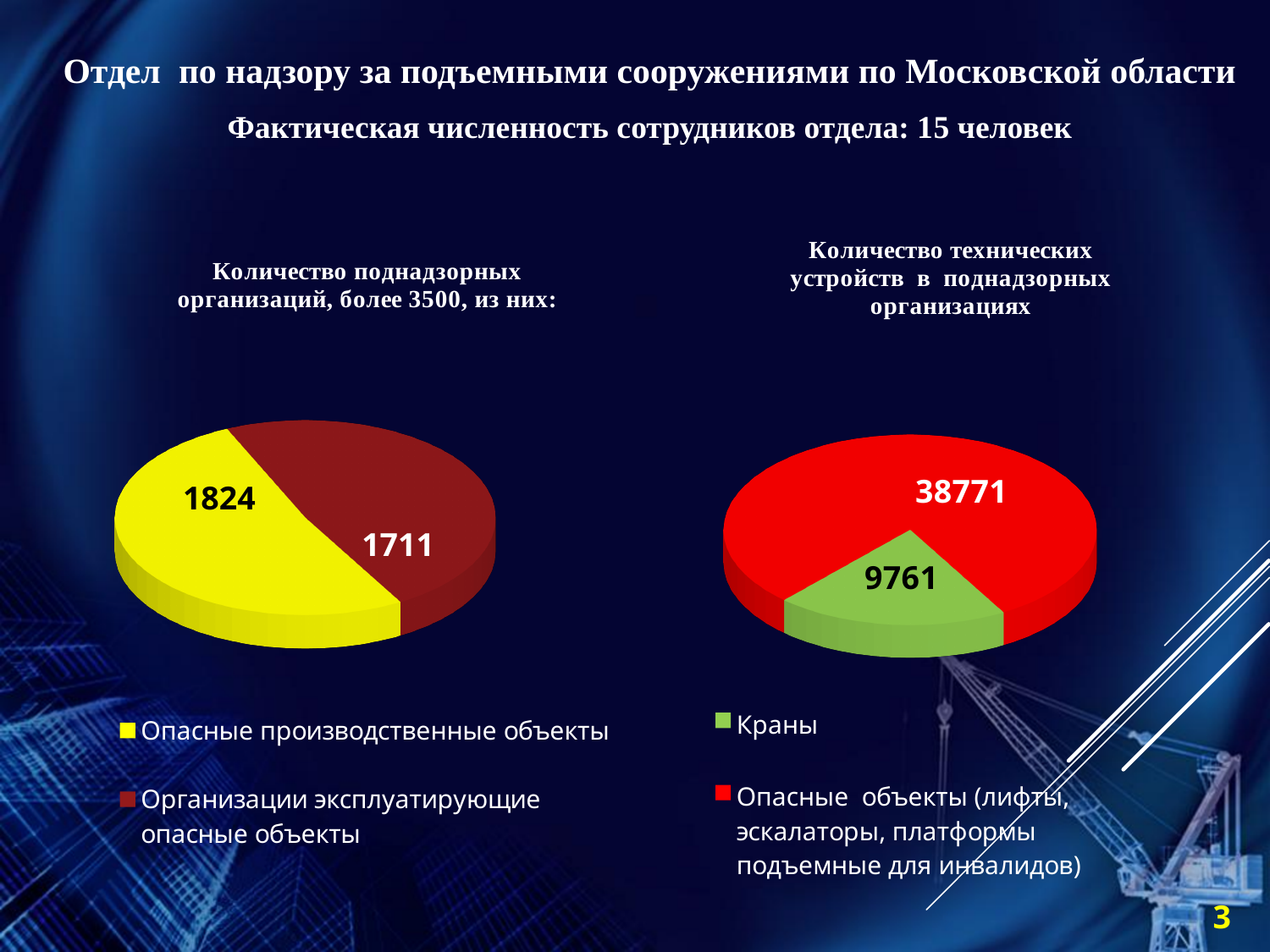
In the right pie chart (Количество технических устройств в поднадзорных организациях), what is the value for "Краны"? 9761 In the left pie chart (Количество поднадзорных организаций), what is the value for "Опасные производственные объекты"? 1824 What kind of chart is used on the left side of the slide, titled "Количество поднадзорных организаций, более 3500, из них:"? Pie chart In the right pie chart (Количество технических устройств), how much larger is the value for "Опасные объекты" than the value for "Краны"? 29010 In the left pie chart (Количество поднадзорных организаций), which category has the larger value? Опасные производственные объекты How many entries does the legend of the left pie chart (Количество поднадзорных организаций) list? 2 In the right pie chart (Количество технических устройств в поднадзорных организациях), what is the value for "Опасные объекты (лифты, эскалаторы, платформы подъемные для инвалидов)"? 38771 How many slices does the right pie chart (Количество технических устройств) have? 2 In the right pie chart (Количество технических устройств), which category has the smaller value? Краны In the left pie chart (Количество поднадзорных организаций), what is the value for "Организации эксплуатирующие опасные объекты"? 1711 In the left pie chart (Количество поднадзорных организаций), what is the difference between the two values? 113 In the right pie chart (Количество технических устройств), what colour is the slice for "Краны"? Green